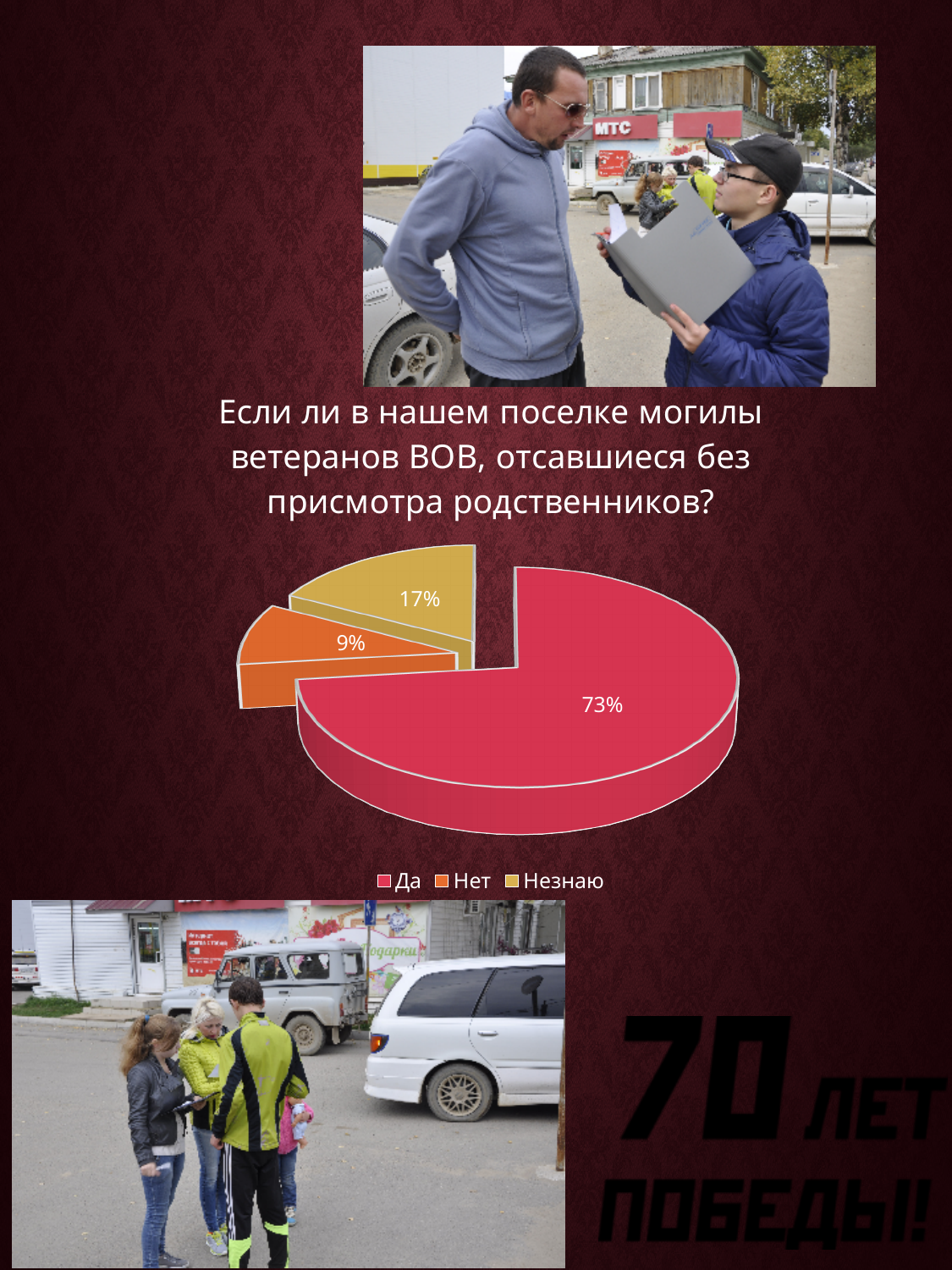
Which category has the smallest slice in the pie chart? Нет What share of the pie chart does the "Незнаю" slice represent? 17% What share of the pie chart does the "Нет" slice represent? 9% What colour is the "Да" slice in the pie chart? Red What are the three legend entries of the pie chart? Да, Нет, Незнаю What share of the pie chart does the "Да" slice represent? 73% How many slices does the pie chart have? 3 What is the difference in percentage points between the "Да" and "Незнаю" slices? 56 Which category has the largest slice in the pie chart? Да Which slice is larger, "Нет" or "Незнаю"? Незнаю What kind of chart is shown on the slide? Pie chart What is the difference in percentage points between the "Незнаю" and "Нет" slices? 8